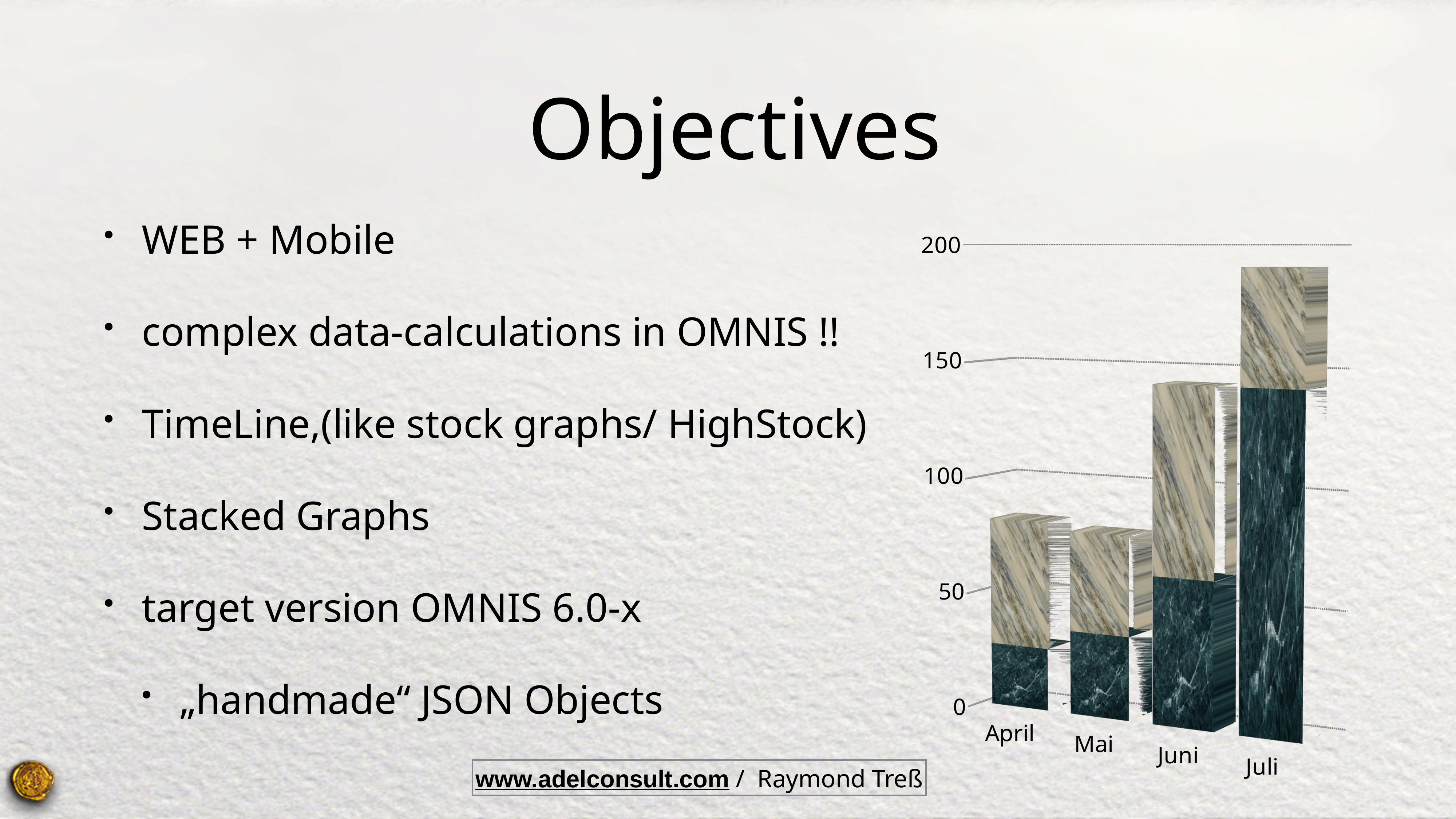
How many stacked segments does each bar in the chart have? 2 Which bar is taller, Juli or April? Juli Do the bar heights generally rise or fall from April to Juli? rise Which bar is taller, Juni or Mai? Juni Is the total value of the Juni bar greater or less than 100? greater What is the highest value labelled on the vertical axis of the chart? 200 Is the total value of the April bar greater or less than 100? less Is the total value of the Juli bar greater or less than 150? greater What kind of chart is shown on the slide? bar chart How many categories are shown on the x axis of the chart? 4 Which category has the tallest bar in the chart? Juli